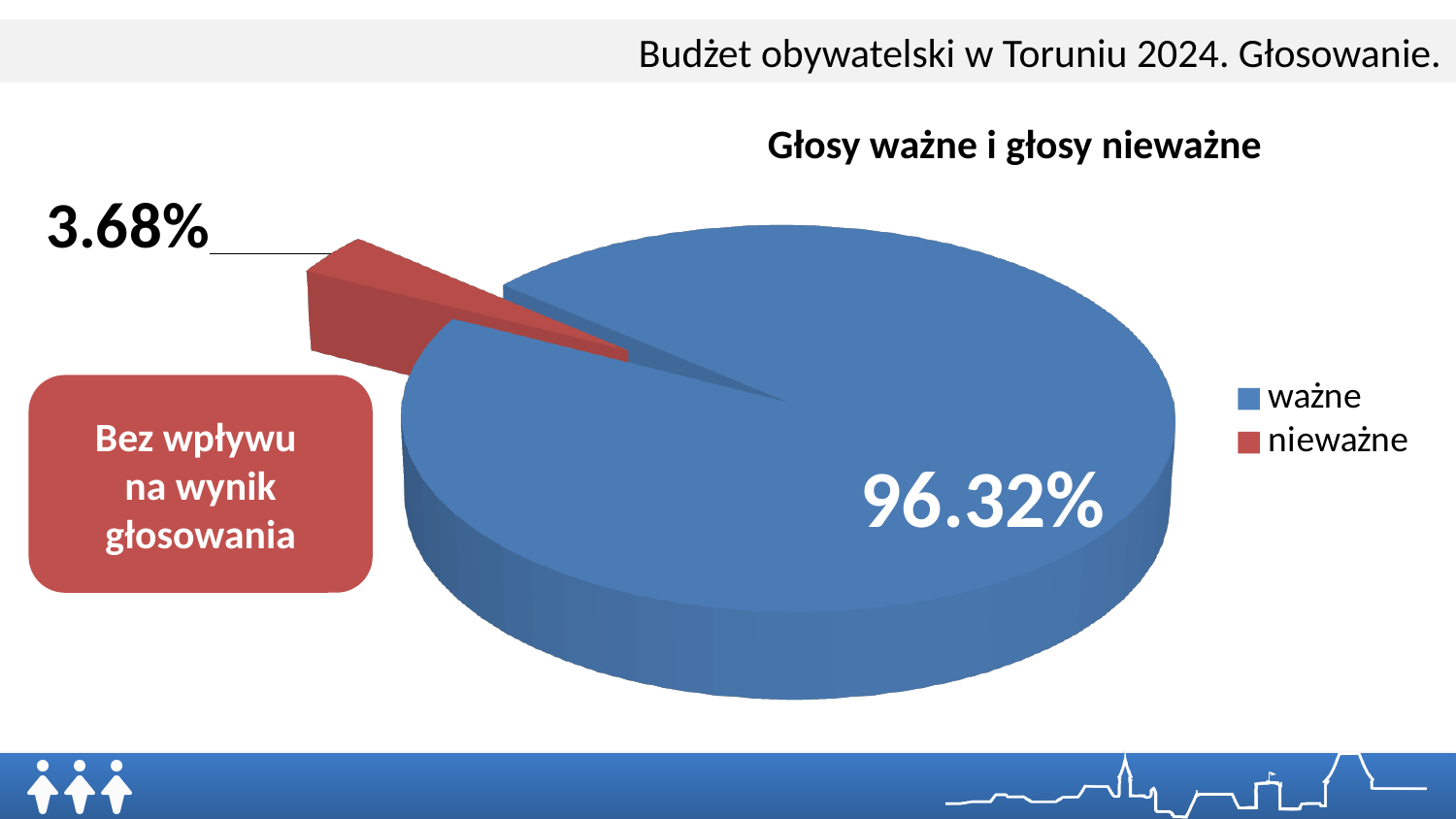
How many entries does the legend list? 2 What kind of chart is shown on the slide? pie chart Which slice is the smallest? nieważne What is the difference in percentage points between the 'ważne' and 'nieważne' slices? 92.64 What share of the pie is labelled 'ważne'? 96.32% What colour is the 'nieważne' slice? red What share of the pie is labelled 'nieważne'? 3.68% What is the chart's title? Głosy ważne i głosy nieważne Which is larger, the 'ważne' slice or the 'nieważne' slice? ważne Which slice is the largest? ważne How many slices does the pie chart have? 2